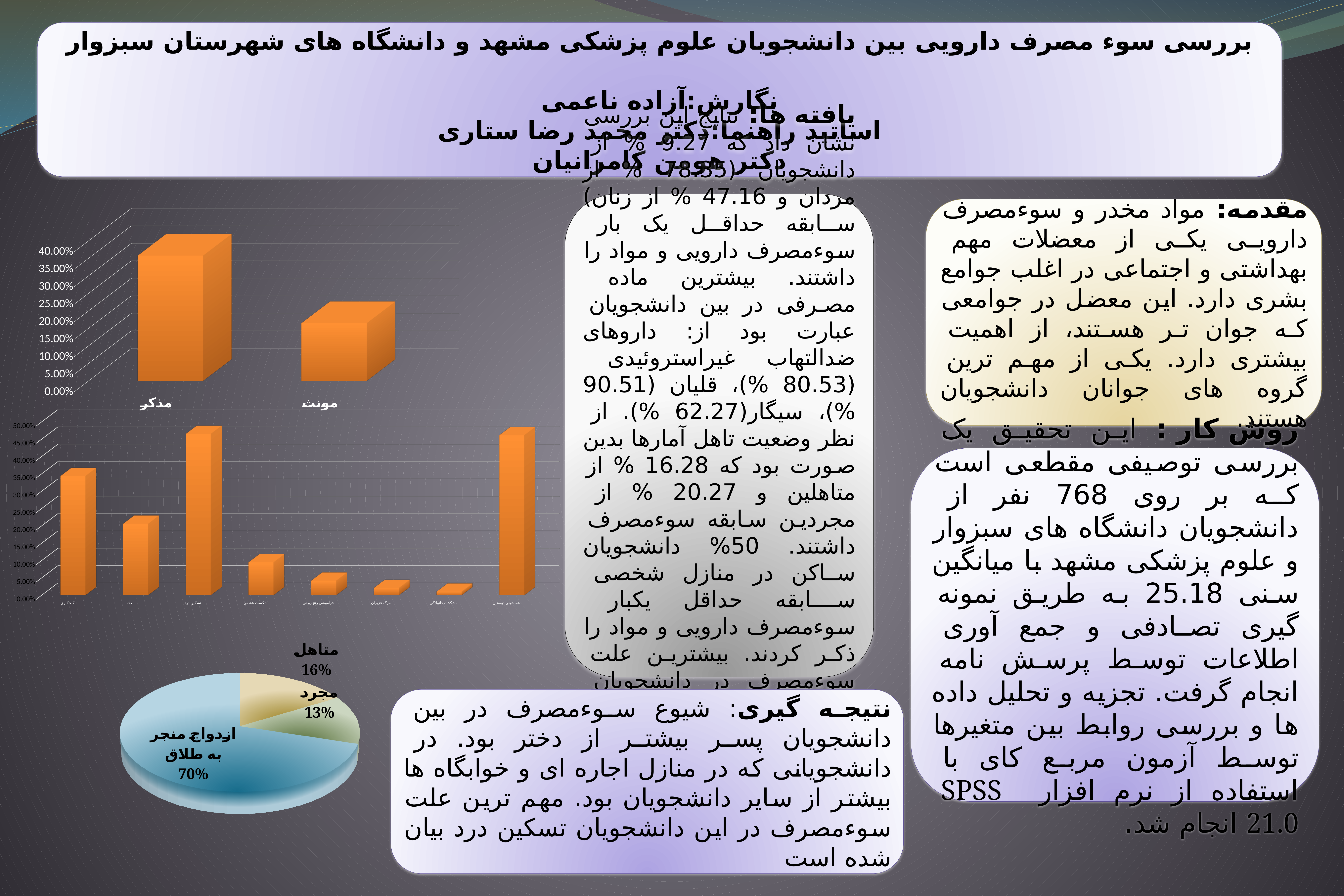
In the pie chart at the bottom-left, which slice is the smallest? مجرد What kind of chart is the chart at the top-left of the slide (with categories مذکر and مونث)? bar chart In the pie chart at the bottom-left, what is the value for متاهل? 16% In the pie chart at the bottom-left, what is the value for ازدواج منجر به طلاق? 70% How many slices does the pie chart at the bottom-left have? 3 In the pie chart at the bottom-left, what is the value for مجرد? 13% In the top-left bar chart, is the value for مذکر greater or less than 30.00%? greater What kind of chart is the chart at the bottom-left of the slide? pie chart In the top-left bar chart, which category has the higher bar, مذکر or مونث? مذکر In the top-left bar chart, is the value for مونث greater or less than 25.00%? less In the pie chart at the bottom-left, which slice is the largest? ازدواج منجر به طلاق In the pie chart at the bottom-left, what is the difference between the values for ازدواج منجر به طلاق and متاهل? 54%